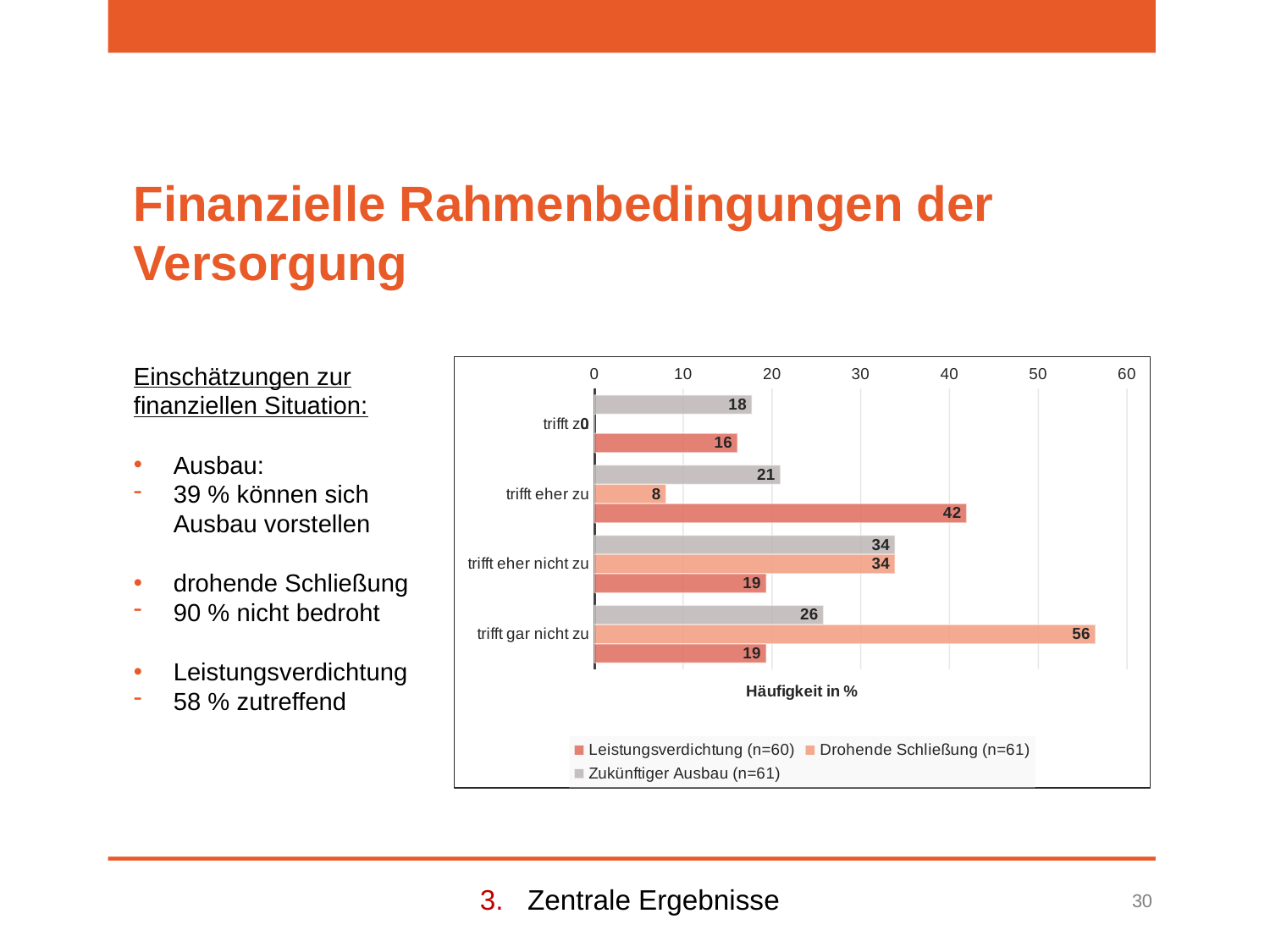
What is the label of the horizontal axis of the chart? Häufigkeit in % How many series does the chart legend list? 3 Which category has the highest value for Drohende Schließung (n=61)? trifft gar nicht zu Which category has the lowest value for Zukünftiger Ausbau (n=61)? trifft zu What is the value for Drohende Schließung (n=61) in the category "trifft gar nicht zu"? 56 How many categories are shown on the vertical axis of the chart? 4 What is the value for Drohende Schließung (n=61) in the category "trifft eher zu"? 8 What is the value for Zukünftiger Ausbau (n=61) in the category "trifft zu"? 18 In the category "trifft eher zu", which series has the larger value: Leistungsverdichtung (n=60) or Zukünftiger Ausbau (n=61)? Leistungsverdichtung (n=60) What is the difference between the Drohende Schließung (n=61) value and the Leistungsverdichtung (n=60) value in the category "trifft gar nicht zu"? 37 What type of chart is shown on the slide? bar chart What is the value for Leistungsverdichtung (n=60) in the category "trifft eher zu"? 42